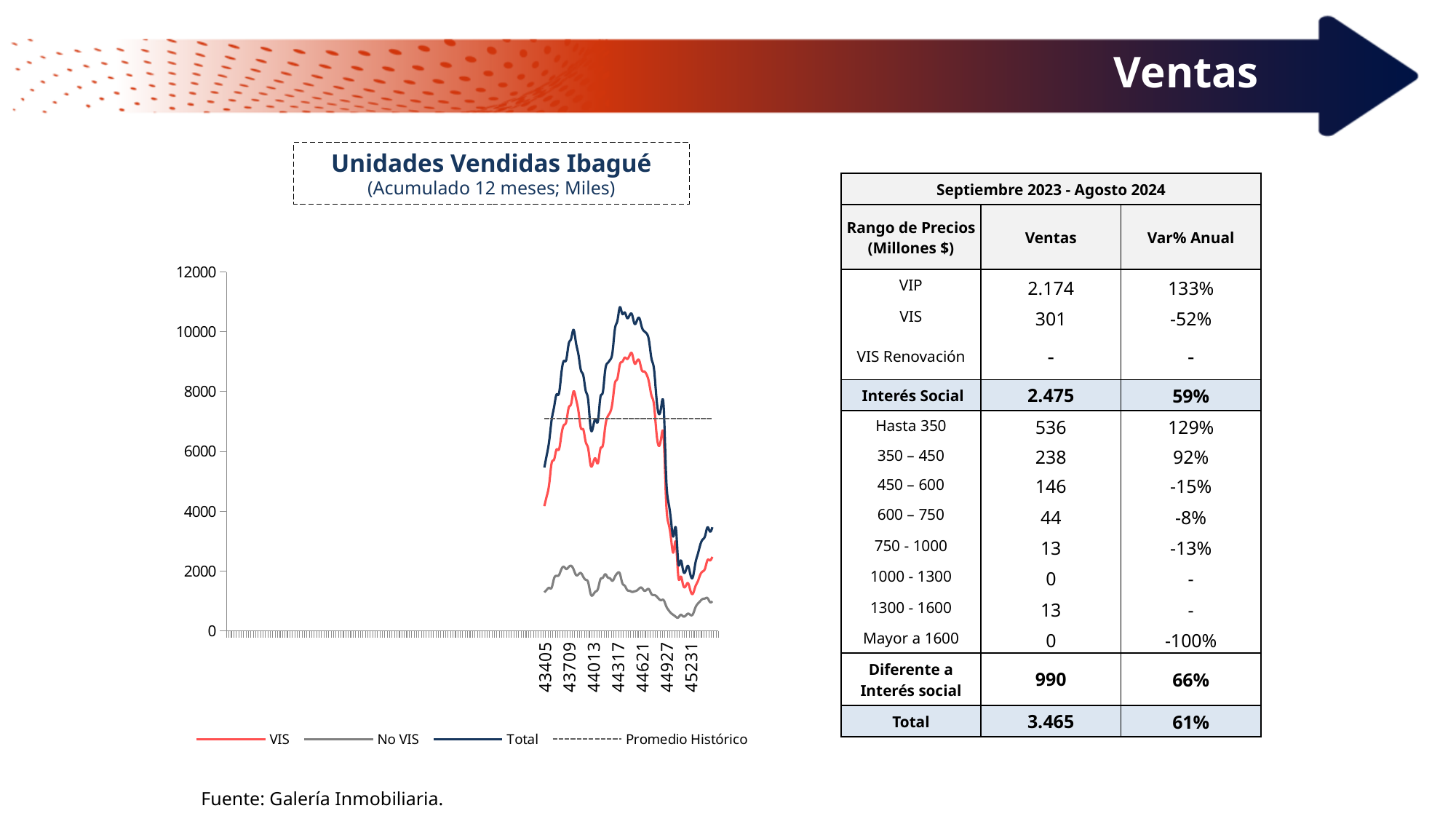
In the 'Unidades Vendidas Ibagué' chart, which series reaches the highest value? Total What are the series names in the legend of the 'Unidades Vendidas Ibagué' chart? VIS, No VIS, Total, Promedio Histórico How many series does the legend of the 'Unidades Vendidas Ibagué' chart list? 4 In the 'Unidades Vendidas Ibagué' chart, which is larger at the x-axis tick 44621: the Total series or the VIS series? Total In the 'Unidades Vendidas Ibagué' chart, does the Total series rise or fall between the x-axis ticks 44621 and 44927? fall In the 'Unidades Vendidas Ibagué' chart, which series stays lowest throughout? No VIS What kind of chart is 'Unidades Vendidas Ibagué'? line chart What is the subtitle shown under the title 'Unidades Vendidas Ibagué'? (Acumulado 12 meses; Miles) In the 'Unidades Vendidas Ibagué' chart, is the Promedio Histórico line greater or less than 6000? greater In the 'Unidades Vendidas Ibagué' chart, is the peak value of the Total series greater or less than 10000? greater In the 'Unidades Vendidas Ibagué' chart, is the highest value of the No VIS series greater or less than 4000? less What is the highest tick value shown on the y-axis of the 'Unidades Vendidas Ibagué' chart? 12000